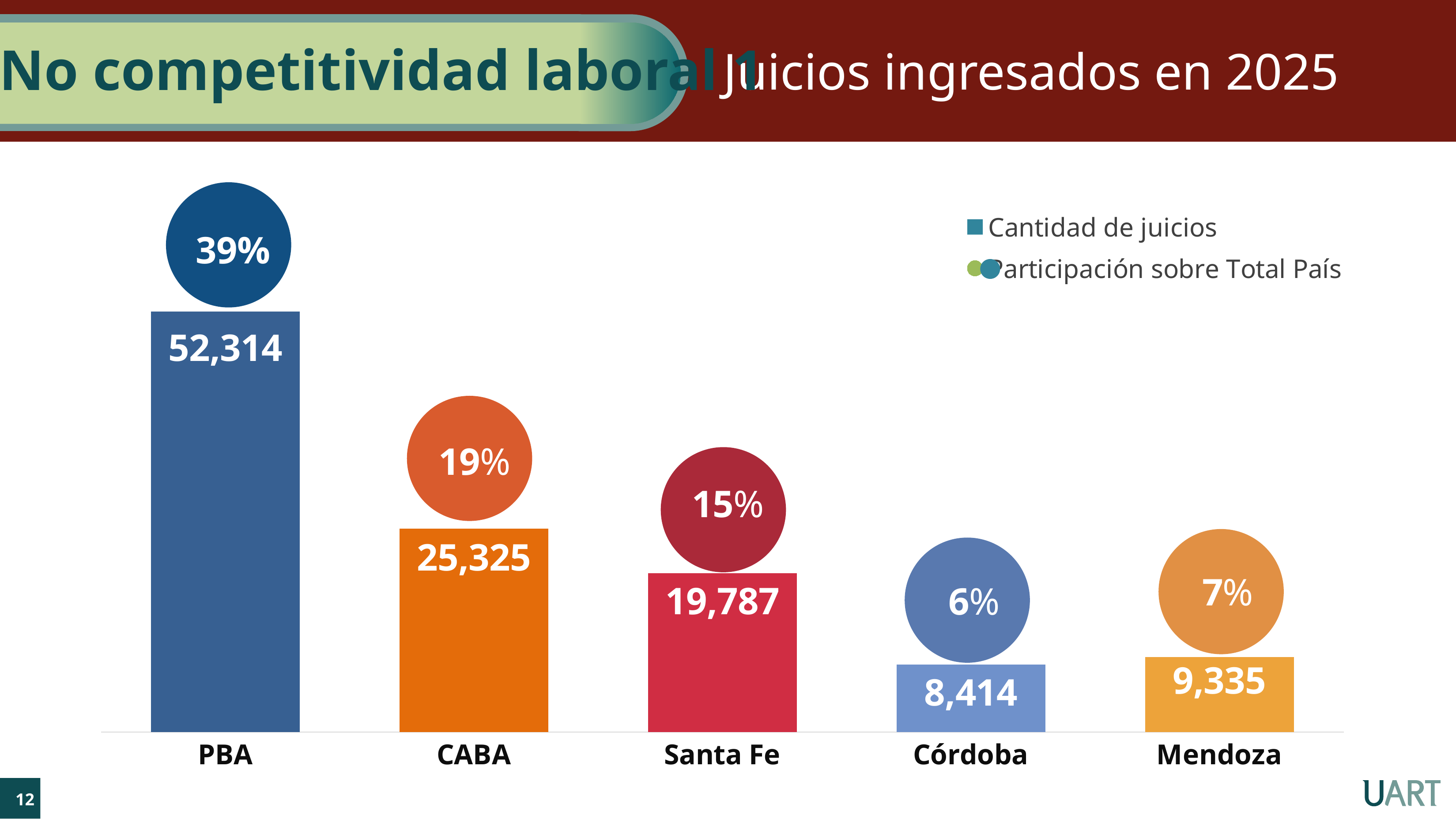
What kind of chart is shown on the slide? Bar chart What is the Participación sobre Total País for Mendoza? 7% How many provinces are shown on the x axis? 5 What is the difference in number of juicios between PBA and CABA? 26,989 What is the number of juicios (Cantidad de juicios) for PBA? 52,314 Which has more juicios, Mendoza or Córdoba? Mendoza What is the number of juicios for Santa Fe? 19,787 What is the difference in Participación sobre Total País between PBA and Santa Fe? 24% What is the Participación sobre Total País for CABA? 19% Which province has the highest number of juicios? PBA Which province has the lowest number of juicios? Córdoba How many series does the legend list? 2